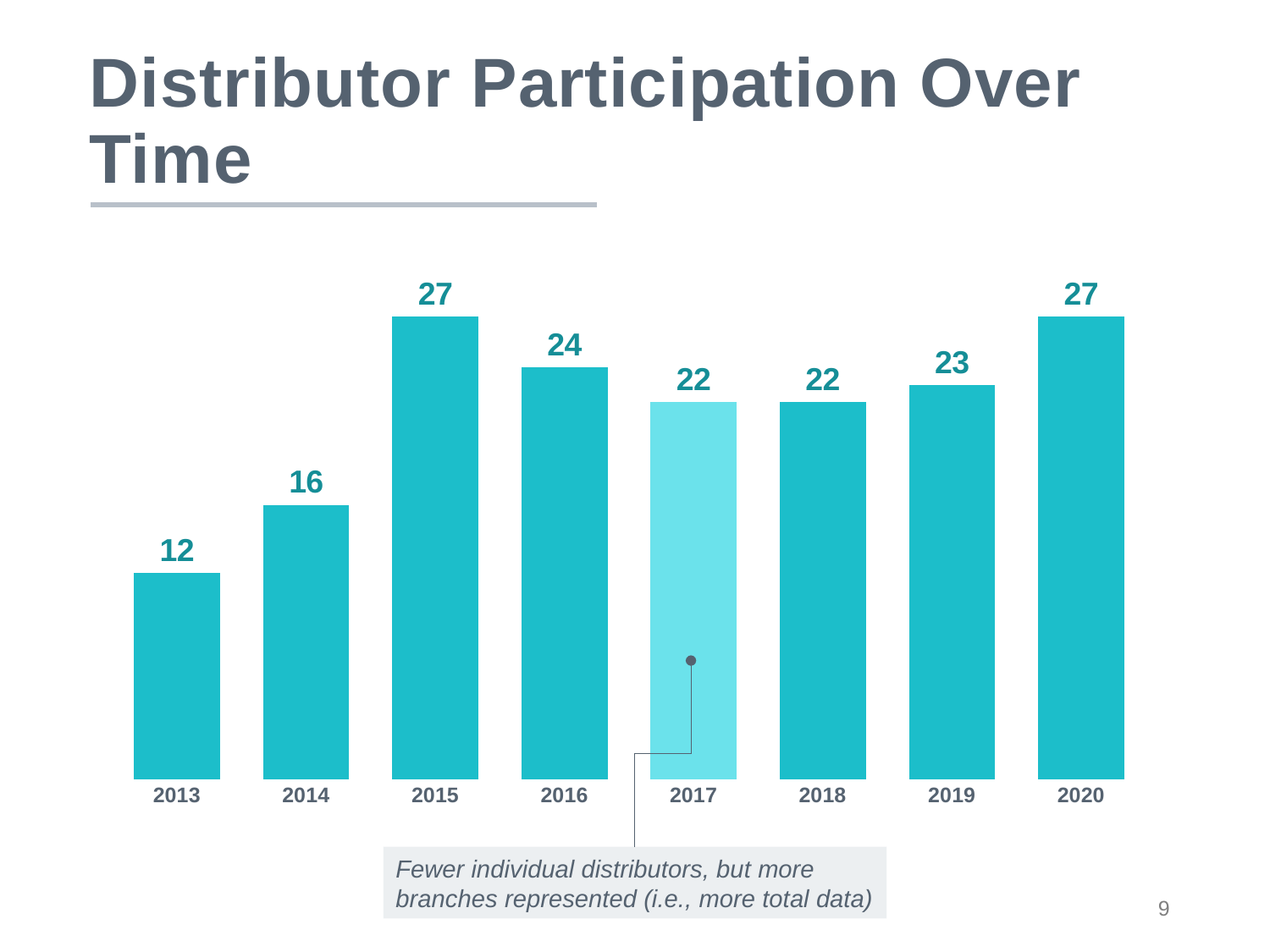
How many years are shown on the x axis? 8 Which year's bar is highlighted in a lighter colour with a callout note? 2017 What kind of chart is shown on the slide? Bar chart Which is larger, the value for 2016 or the value for 2018? 2016 What is the value for 2013? 12 Do the values rise or fall from 2013 to 2015? Rise What is the value for 2016? 24 What is the difference between the values for 2020 and 2017? 5 What is the difference between the values for 2015 and 2014? 11 What is the value for 2019? 23 Which years share the highest value of 27? 2015 and 2020 Which year has the lowest value? 2013